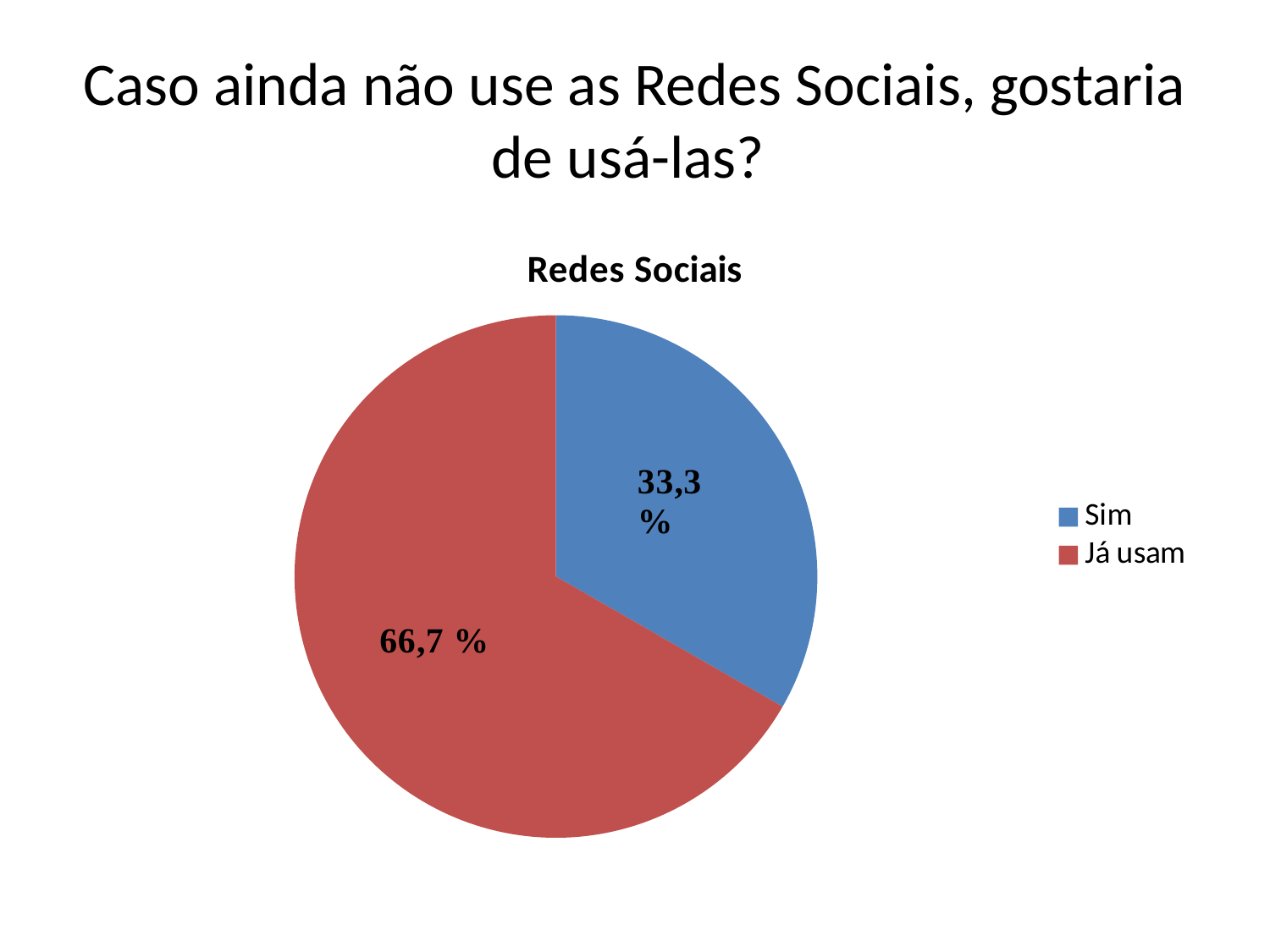
What share of the pie does the 'Sim' slice represent? 33,3 % Which is larger, the 'Sim' slice or the 'Já usam' slice? Já usam What kind of chart is shown on the slide? pie chart What colour is the 'Já usam' slice? red What share of the pie does the 'Já usam' slice represent? 66,7 % How many slices does the pie chart have? 2 How many entries does the legend list? 2 What is the difference in percentage points between the 'Já usam' slice and the 'Sim' slice? 33,4 % Which slice is the smallest in the pie chart? Sim What is the title of the chart? Redes Sociais Which slice is the largest in the pie chart? Já usam